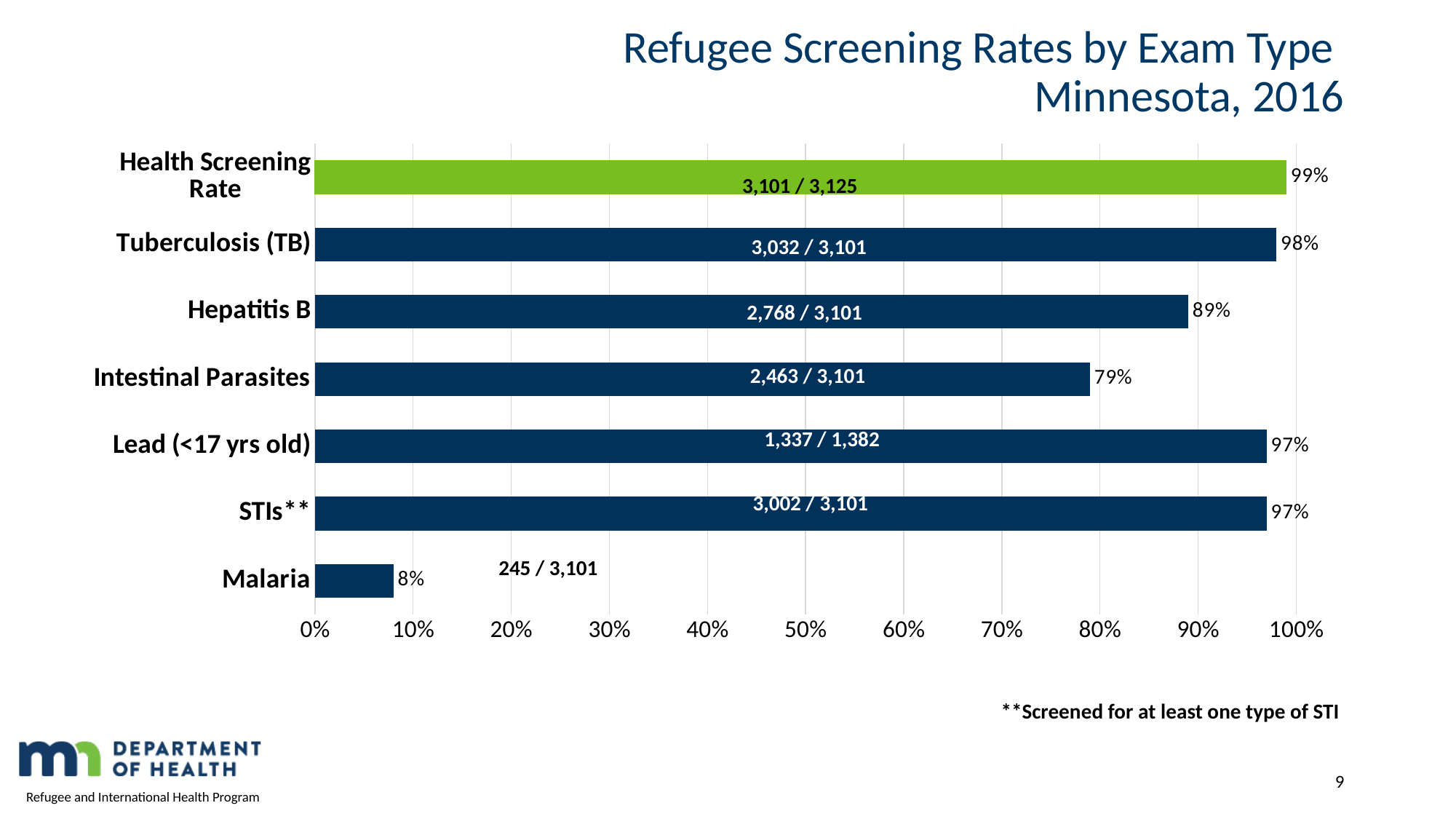
What fraction is shown on the Tuberculosis (TB) bar? 3,032 / 3,101 What is the screening rate for Malaria? 8% How many categories are shown on the chart? 7 Which category has the highest screening rate? Health Screening Rate What type of chart is shown on the slide? Bar chart What fraction is shown for Lead (<17 yrs old)? 1,337 / 1,382 Which category has the lowest screening rate? Malaria Which bar is coloured green rather than dark blue? Health Screening Rate What is the difference in percentage points between the Tuberculosis (TB) rate and the Intestinal Parasites rate? 19 Which has a higher screening rate, Hepatitis B or Intestinal Parasites? Hepatitis B What is the screening rate for Hepatitis B? 89% What is the screening rate for Intestinal Parasites? 79%